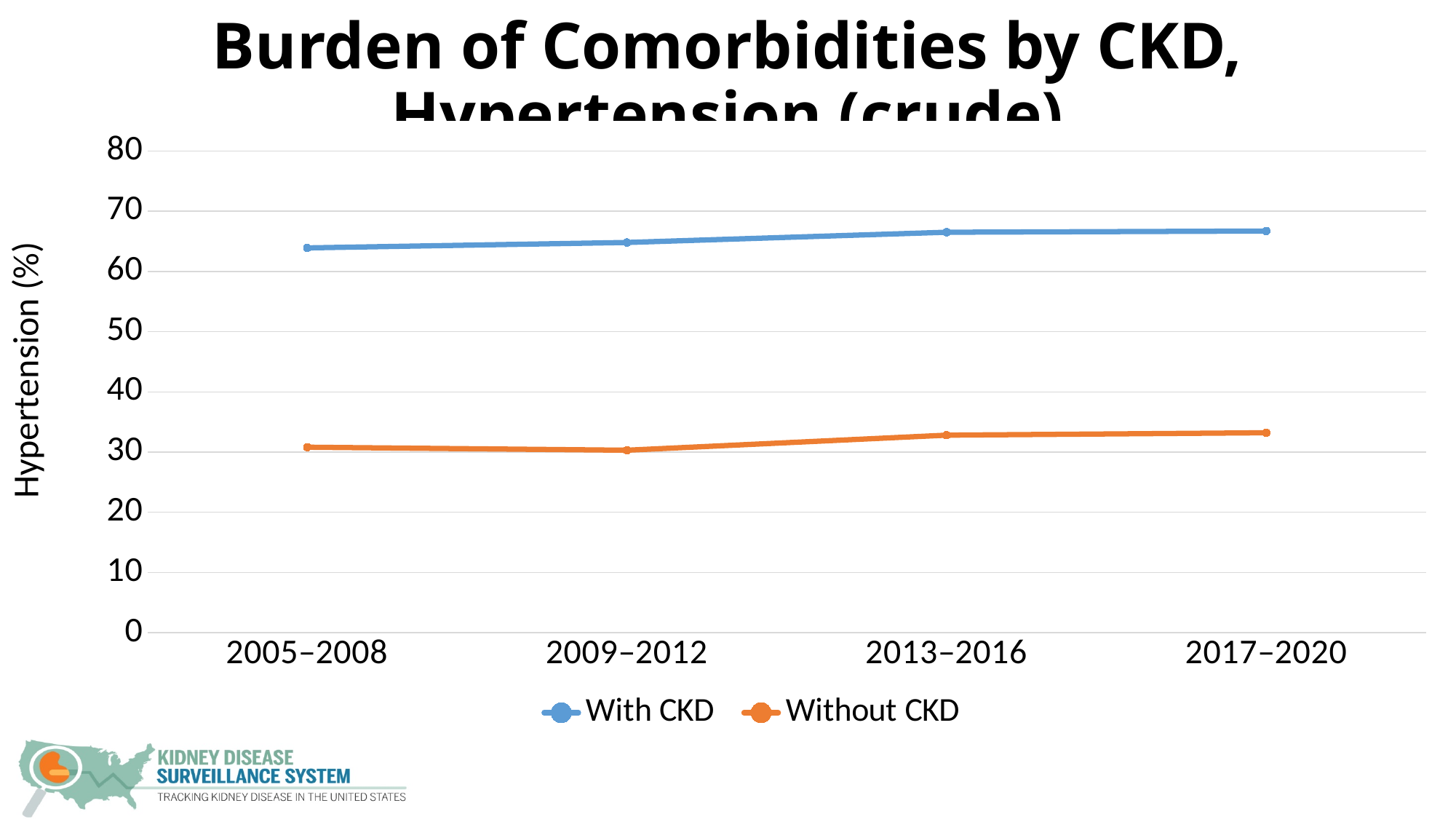
Do the values for With CKD rise or fall from 2005–2008 to 2017–2020? rise What kind of chart is shown on the slide? line chart What colour is the line for Without CKD? orange Is the value for Without CKD in 2017–2020 greater or less than 30? greater Is the value for With CKD in 2005–2008 greater or less than 60? greater Is the value for Without CKD in 2005–2008 greater or less than 20? greater What is the label on the y axis? Hypertension (%) How many series does the legend list? 2 In 2013–2016, which series has the larger value, With CKD or Without CKD? With CKD How many time periods are plotted along the x axis? 4